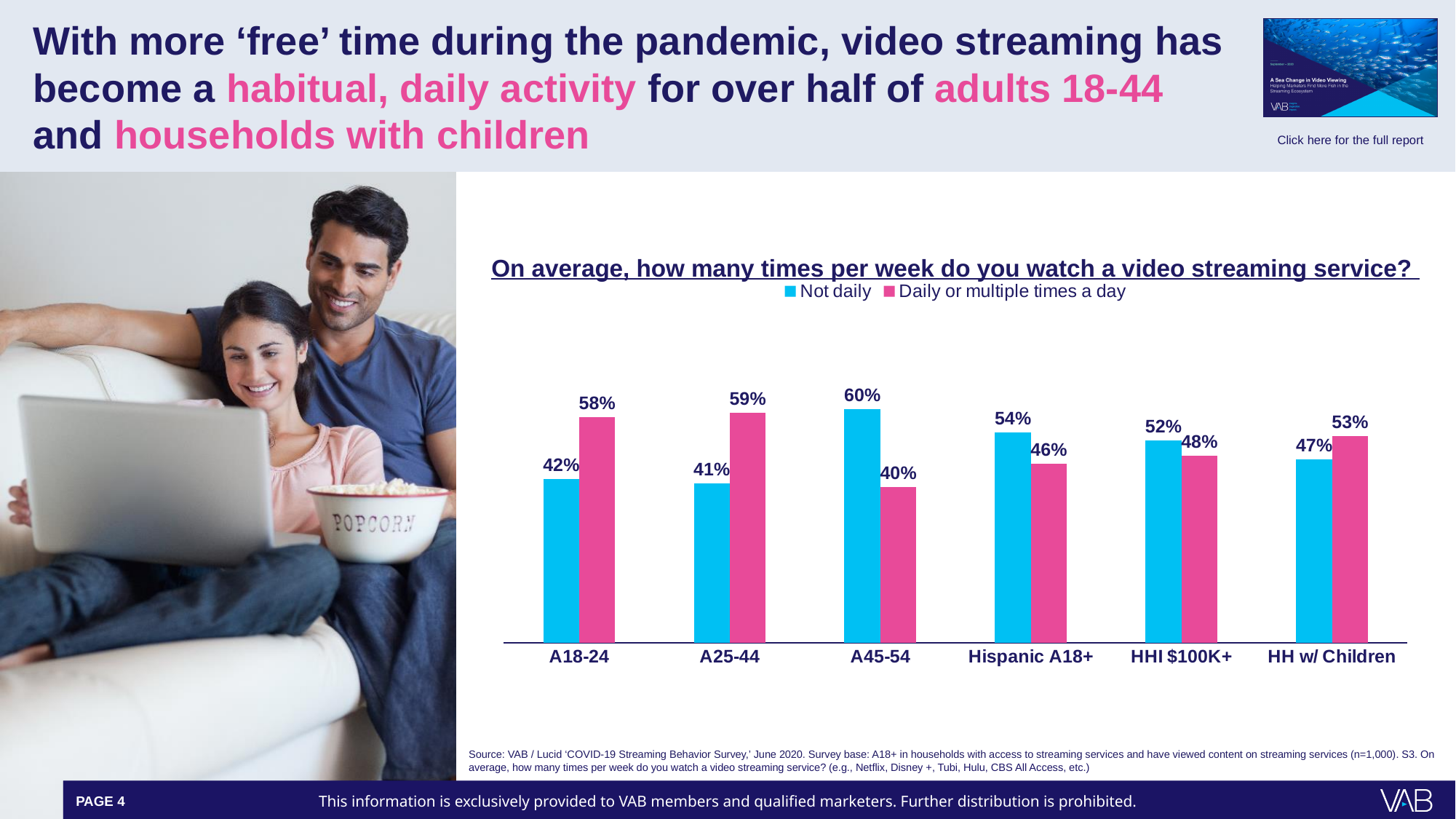
What is the title of the chart? On average, how many times per week do you watch a video streaming service? What kind of chart is shown on the slide? Bar chart What percentage of A18-24 watch a video streaming service daily or multiple times a day? 58% How many categories are shown on the x axis of the chart? 6 What is the 'Not daily' value for A45-54? 60% Which category has the highest 'Daily or multiple times a day' value? A25-44 What is the 'Daily or multiple times a day' value for HH w/ Children? 53% For Hispanic A18+, which is larger: 'Not daily' or 'Daily or multiple times a day'? Not daily Which category has the lowest 'Not daily' value? A25-44 What is the difference between the 'Not daily' and 'Daily or multiple times a day' values for A45-54? 20% How many series does the chart's legend list? 2 Which colour represents the 'Daily or multiple times a day' series? Pink